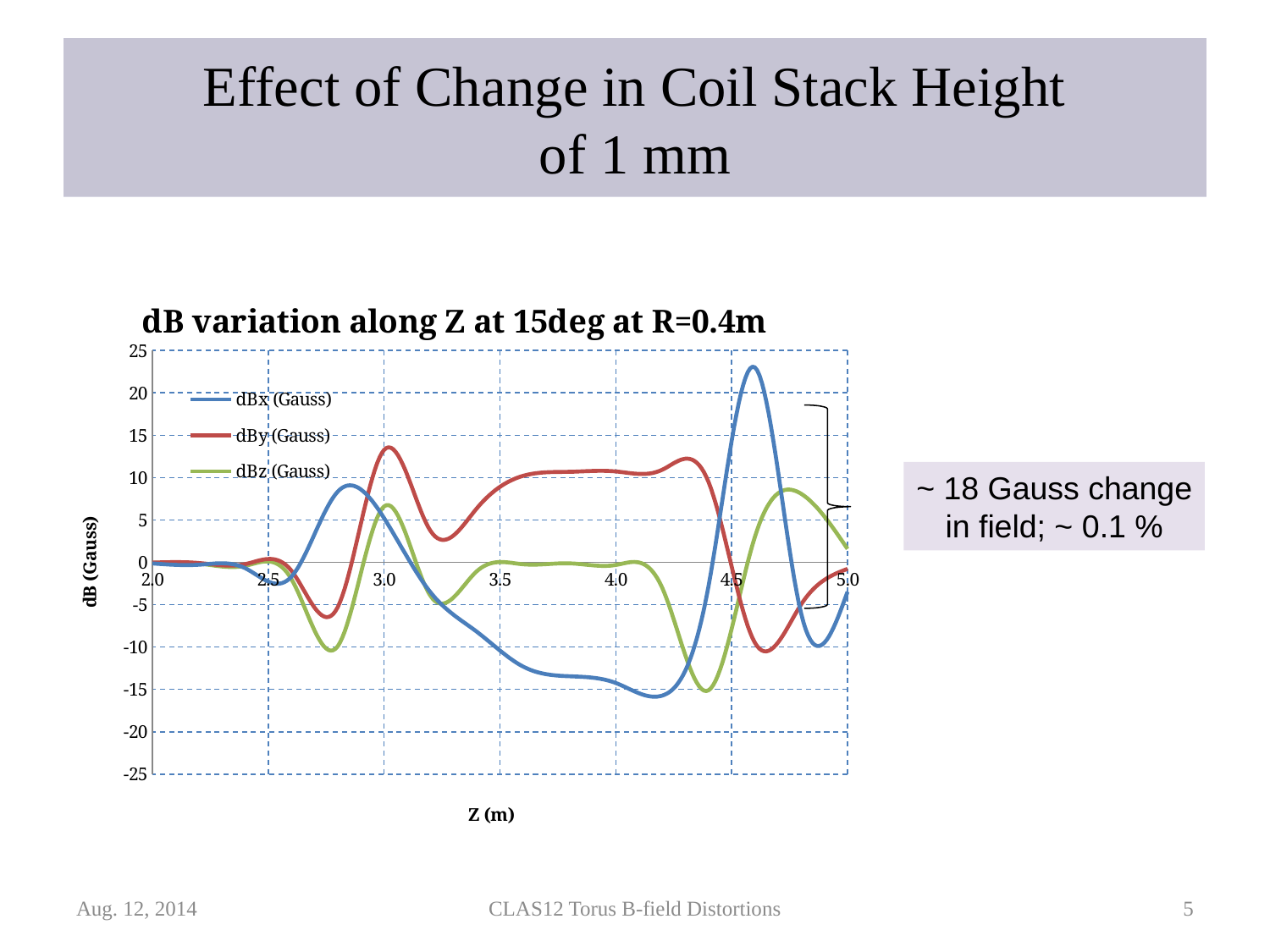
What is the label of the x axis of the chart? Z (m) At Z = 3.5, which series has the larger value, dBx (Gauss) or dBy (Gauss)? dBy (Gauss) What kind of chart is shown on the slide? line chart At Z = 3.0, which series has the larger value, dBy (Gauss) or dBz (Gauss)? dBy (Gauss) Is the peak value of dBz (Gauss) near Z = 4.7 greater or less than 5? greater How many series does the chart legend list? 3 Does dBx (Gauss) rise or fall as Z goes from 3.0 to 4.0? fall What is the title of the chart? dB variation along Z at 15deg at R=0.4m Is the value of dBy (Gauss) at Z = 3.0 greater or less than 10? greater Is the value of dBx (Gauss) at Z = 4.0 greater or less than -10? less Which series reaches the highest value anywhere on the chart? dBx (Gauss)